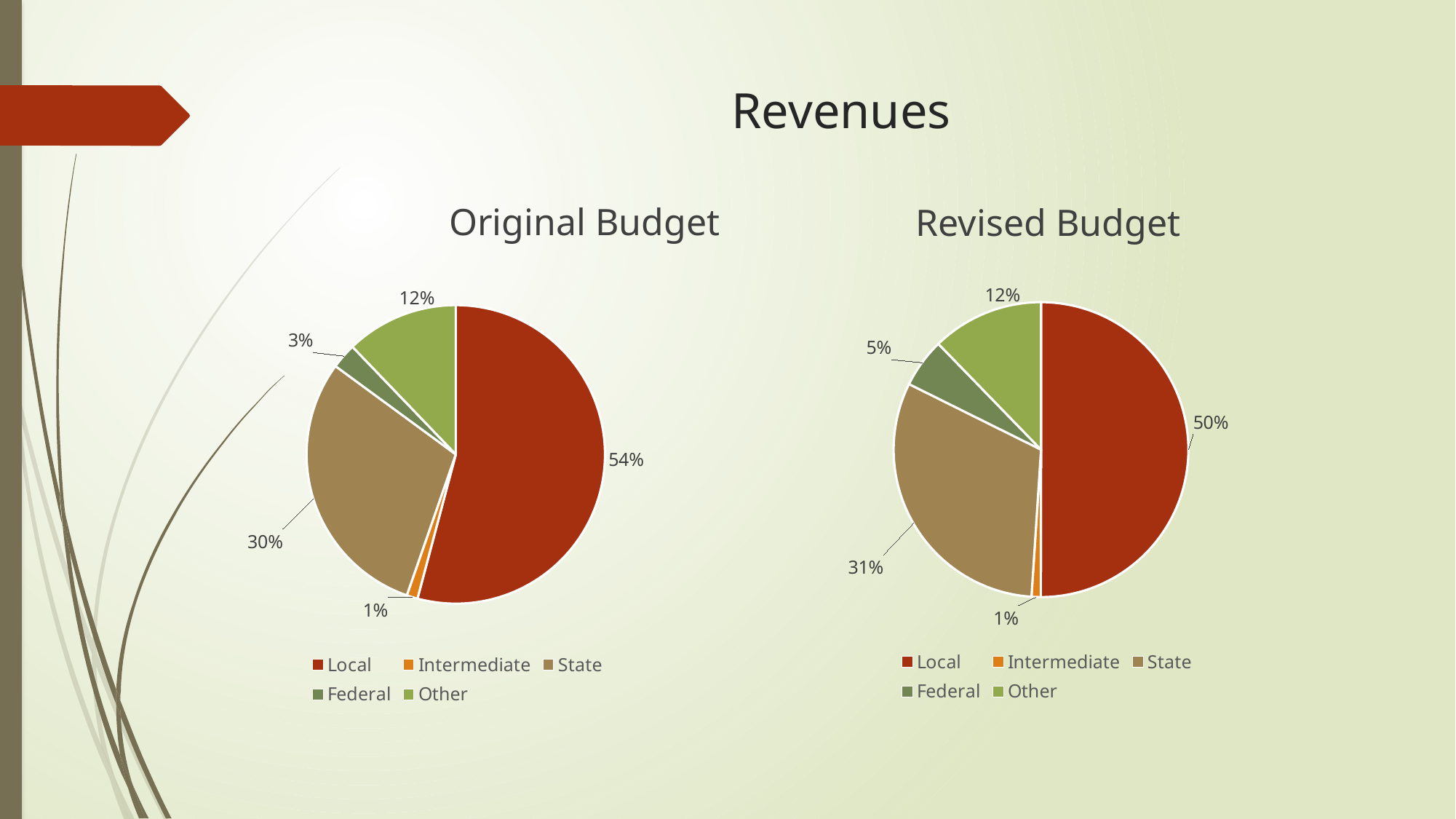
How many slices does the Original Budget pie chart have? 5 In the Original Budget chart, what share does Local have? 54% Which is larger: the Federal share in the Original Budget chart or the Federal share in the Revised Budget chart? Revised Budget In the Revised Budget chart, what share does State have? 31% In the Original Budget chart, which category has the largest share? Local In the Original Budget chart, what is the difference between the State share and the Other share? 18% What is the title of the slide containing the two charts? Revenues In the Revised Budget chart, what share does Federal have? 5% What is the difference between the Local share in the Original Budget chart and the Local share in the Revised Budget chart? 4% What type of chart is the Revised Budget chart? Pie chart How many entries does the legend of the Revised Budget chart list? 5 In the Revised Budget chart, which category has the smallest share? Intermediate